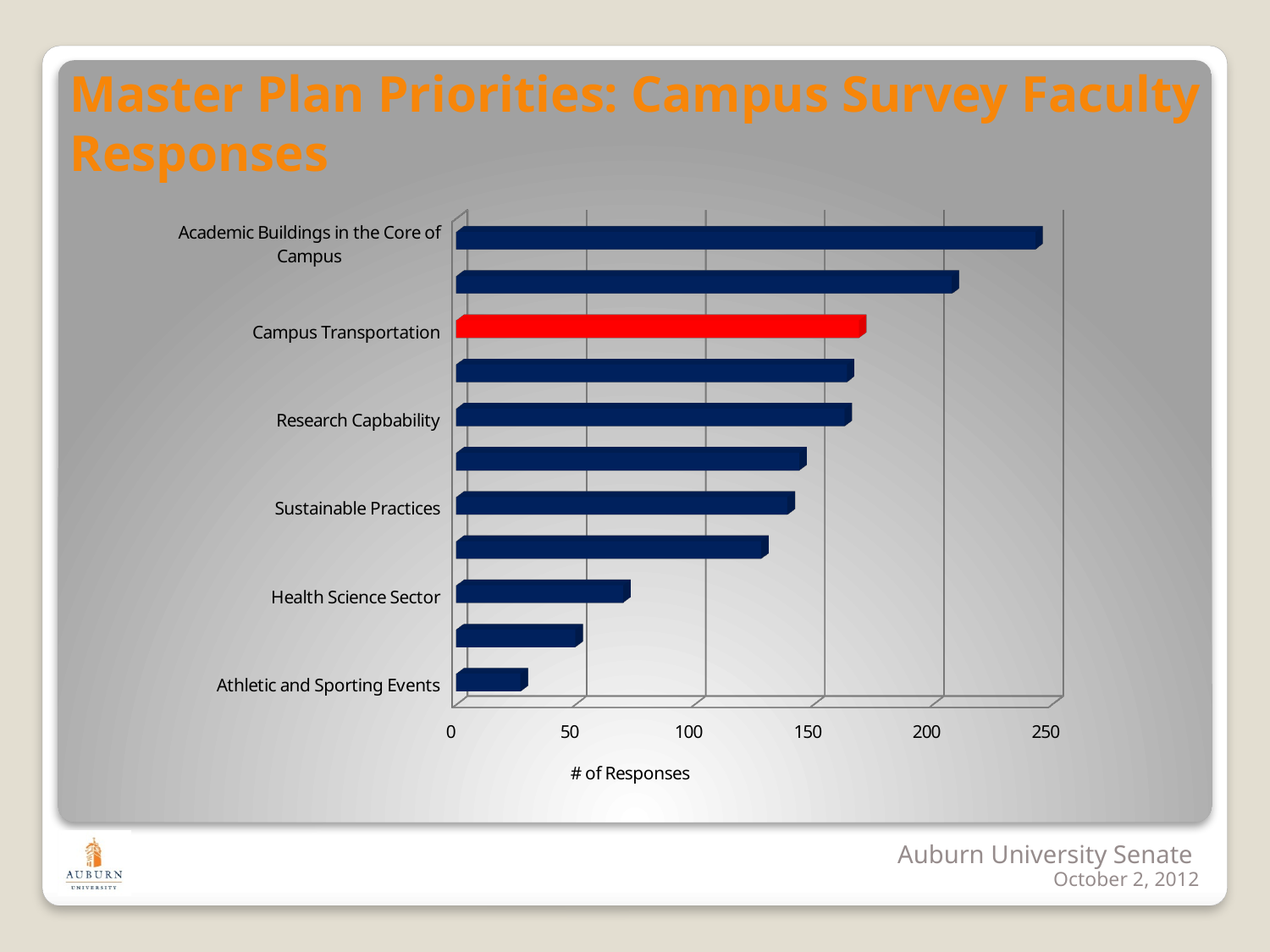
What kind of chart is shown on the slide? bar chart What is the title of the horizontal axis? # of Responses Which labeled category has the lowest number of responses? Athletic and Sporting Events Which has more responses, Campus Transportation or Sustainable Practices? Campus Transportation How many bars are plotted in the chart? 11 Is the value for Academic Buildings in the Core of Campus greater or less than 200? greater Is the value for Athletic and Sporting Events greater or less than 50? less Is the value for Campus Transportation greater or less than 150? greater Which labeled category has the highest number of responses? Academic Buildings in the Core of Campus Which category's bar is colored red? Campus Transportation